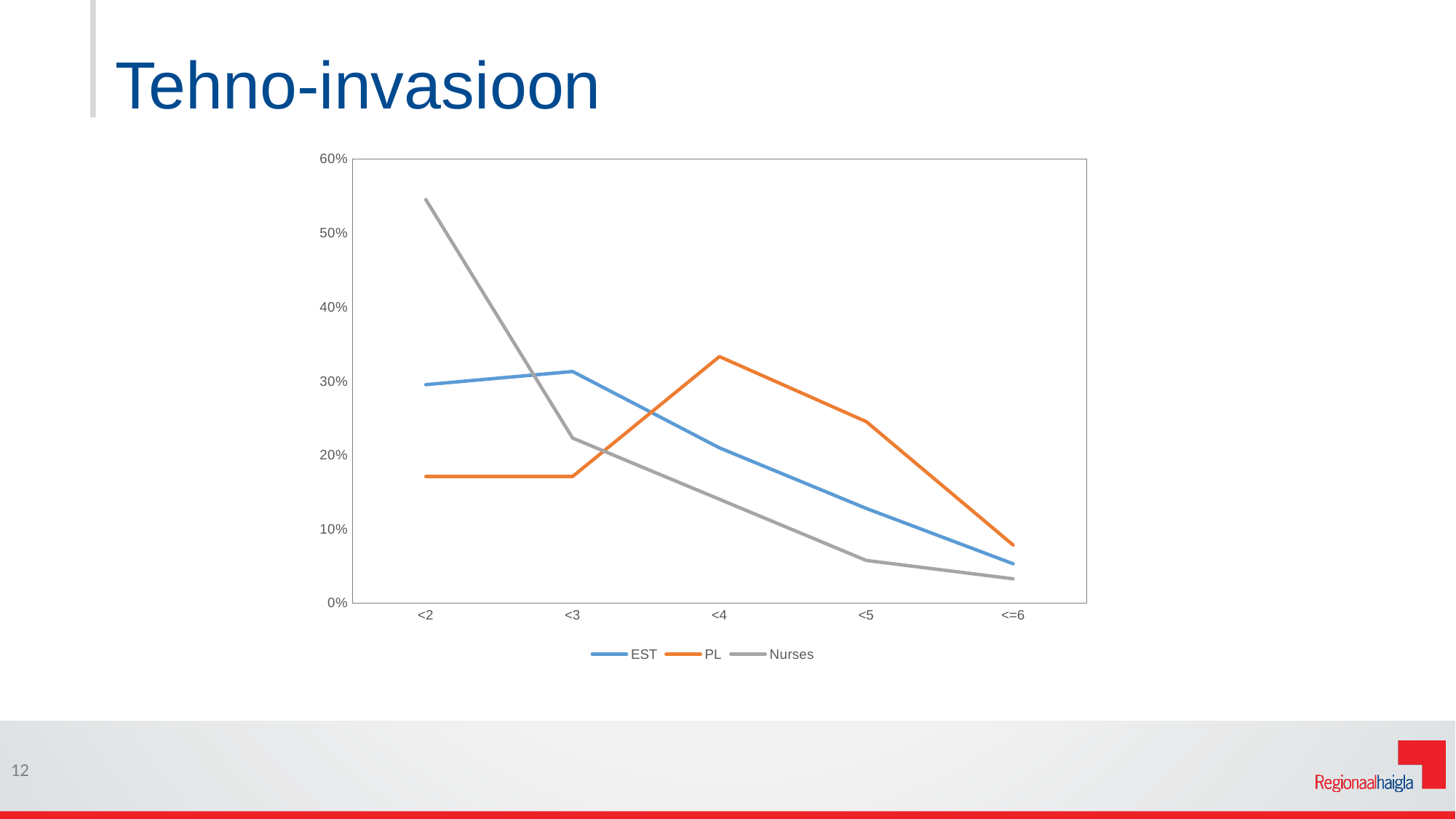
Is the value for PL at <4 greater or less than 30%? greater What kind of chart is shown on the slide? line chart How many categories are shown on the x axis? 5 Is the value for EST at <=6 greater or less than 10%? less Is the value for Nurses at <2 greater or less than 50%? greater At which category does the PL series reach its highest value? <4 What is the title of the slide containing the chart? Tehno-invasioon Which series has the highest value at <2? Nurses Do the values for Nurses rise or fall along the x axis? fall How many series does the legend list? 3 Which is larger at <5, the value for PL or the value for EST? PL Which series is drawn in orange? PL